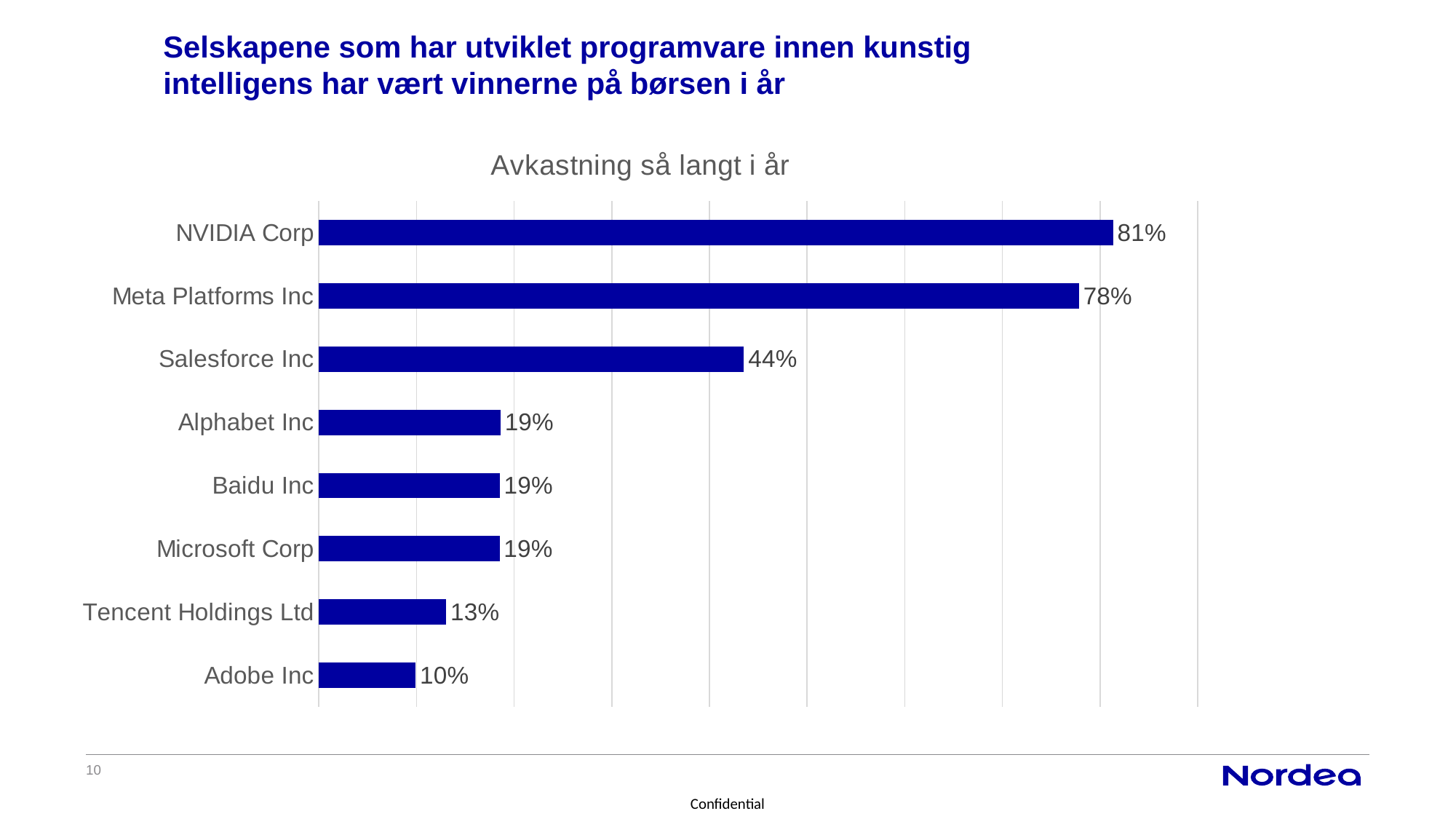
What is the value for NVIDIA Corp? 81% Which company has the highest return so far this year? NVIDIA Corp What is the difference between the values for NVIDIA Corp and Meta Platforms Inc? 3% Which company has the lowest return so far this year? Adobe Inc What kind of chart is shown on the slide? Bar chart What is the value for Adobe Inc? 10% What is the difference between the values for Salesforce Inc and Alphabet Inc? 25% Which is larger, the value for Meta Platforms Inc or the value for Salesforce Inc? Meta Platforms Inc What is the value for Tencent Holdings Ltd? 13% How many companies are shown in the chart? 8 What is the title of the chart? Avkastning så langt i år What is the value for Salesforce Inc? 44%